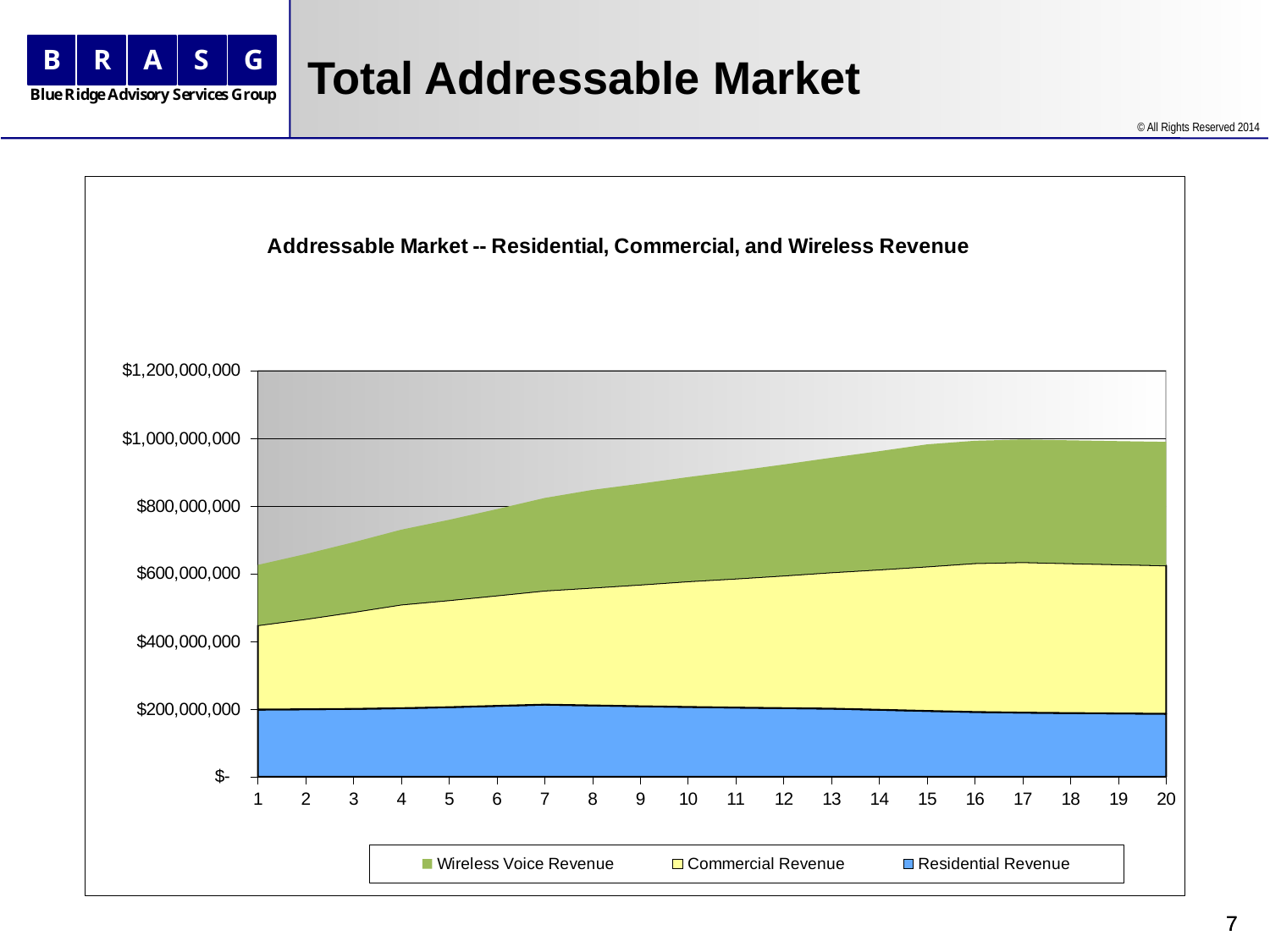
How many series does the legend list? 3 Which series is shown in green? Wireless Voice Revenue Is the total of all three series at period 1 greater or less than $800,000,000? less Is the total of all three series at period 15 greater or less than $800,000,000? greater Is the combined value of Residential Revenue and Commercial Revenue at period 20 greater or less than $600,000,000? greater Which series contributes the smallest amount at period 20? Residential Revenue How many periods are shown along the x axis? 20 What is the title of the chart? Addressable Market -- Residential, Commercial, and Wireless Revenue What kind of chart is shown on the slide? Stacked area chart Does the total addressable market generally rise or fall from period 1 to period 20? Rise